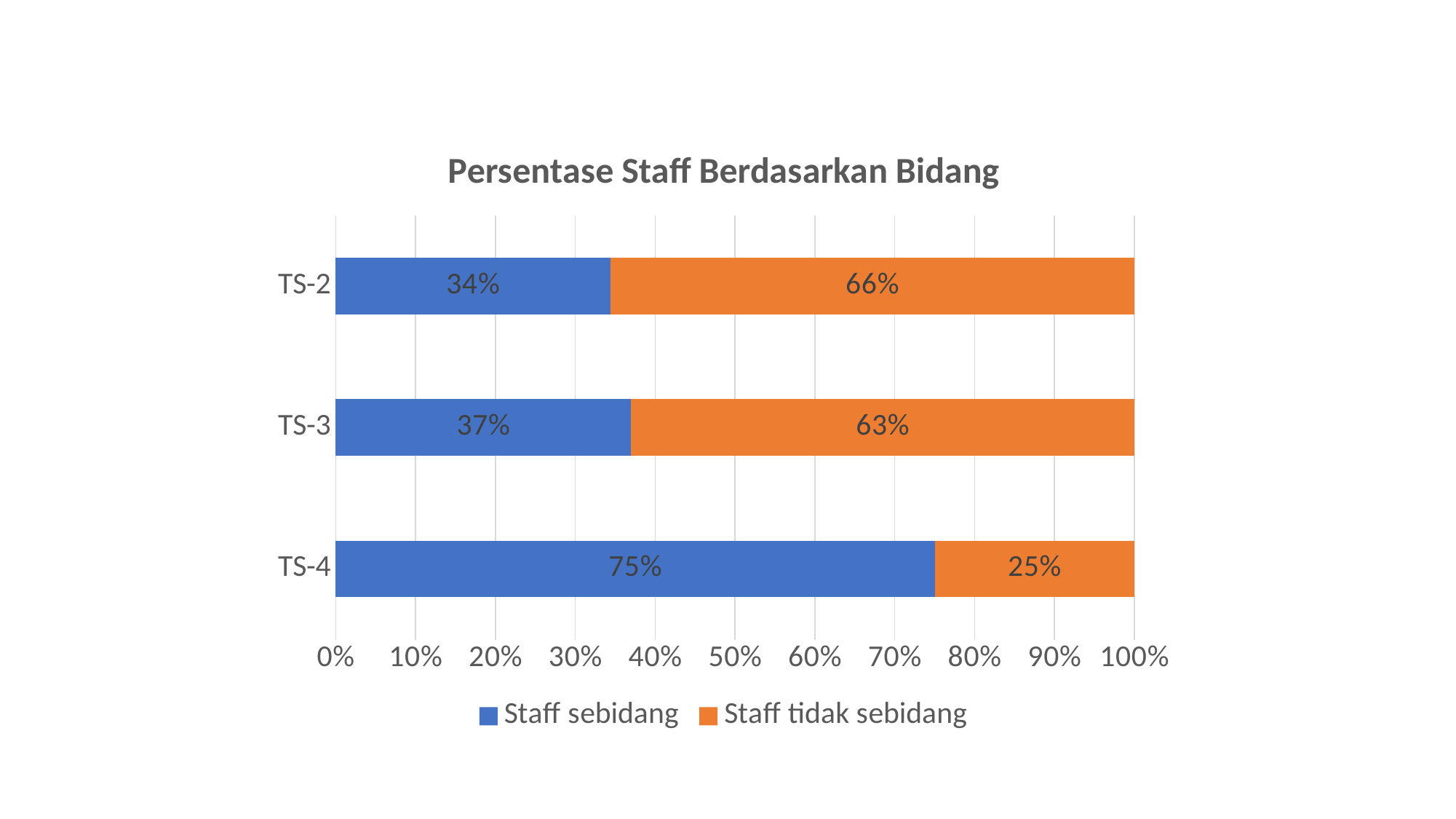
What is the value for Staff sebidang in TS-4? 75% What is the value for Staff tidak sebidang in TS-3? 63% What kind of chart is shown on the slide? Stacked bar chart Which is larger: Staff sebidang in TS-3 or Staff sebidang in TS-2? Staff sebidang in TS-3 What is the difference between the Staff sebidang values for TS-4 and TS-2? 41% What is the title of the chart? Persentase Staff Berdasarkan Bidang What is the total of the stacked bar for TS-3? 100% How many series does the legend list? 2 What is the value for Staff sebidang in TS-2? 34% Which category has the highest value for Staff sebidang? TS-4 Which category has the lowest value for Staff tidak sebidang? TS-4 How many categories are shown on the chart? 3